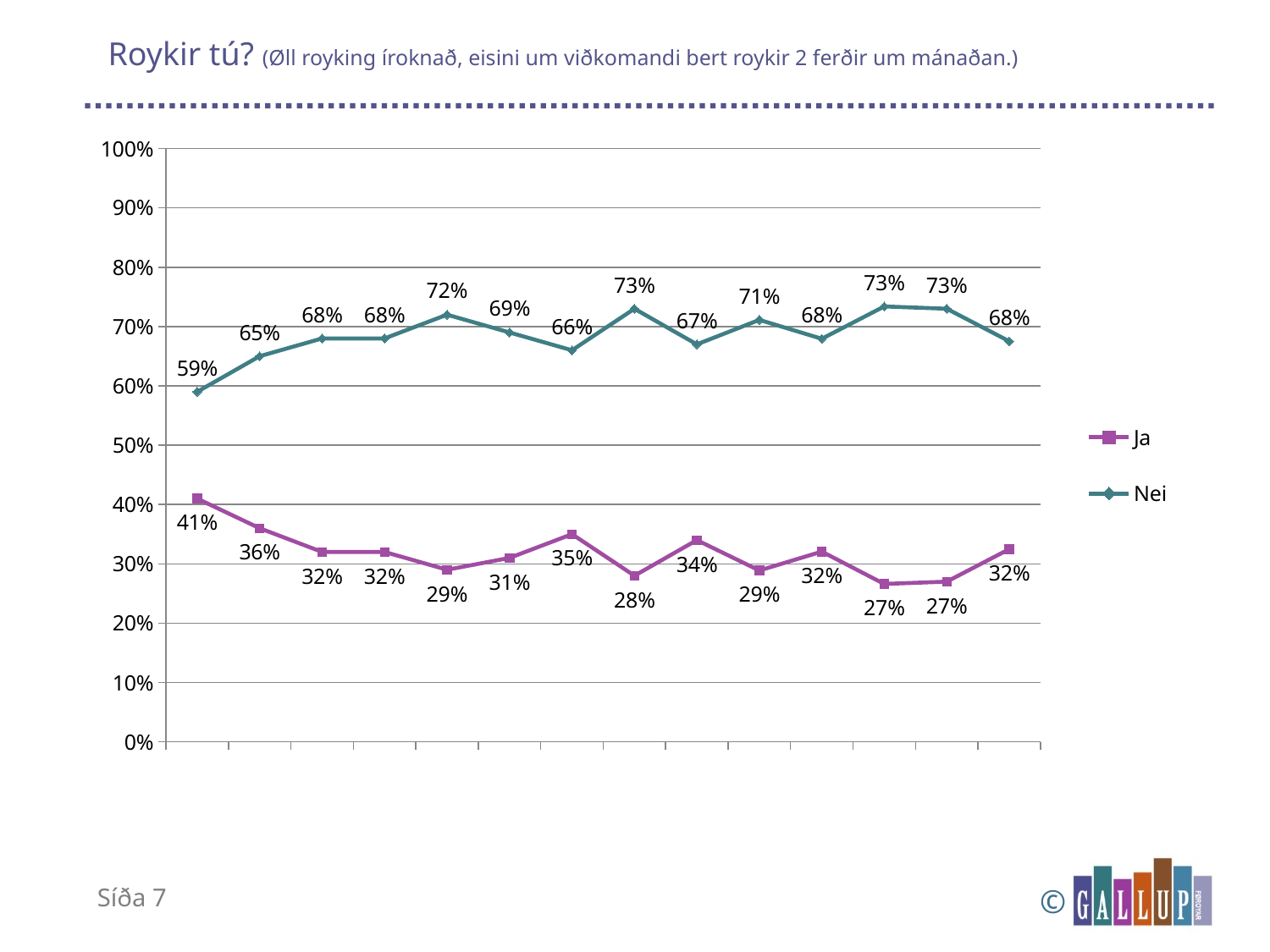
What kind of chart is shown on the slide? line chart What is the difference between the first Nei value and the first Ja value? 18% What is the value of the last point of the Ja series? 32% How many data points does the Nei series have? 14 What is the value of the first point of the Nei series? 59% Is the lowest value of the Nei series greater or less than 50%? greater Which series has higher values throughout the chart, Ja or Nei? Nei What is the lowest value shown for the Ja series? 27% What are the names of the two series in the legend? Ja and Nei What is the value of the first point of the Ja series? 41% What is the highest value shown for the Nei series? 73% How many series does the legend list? 2